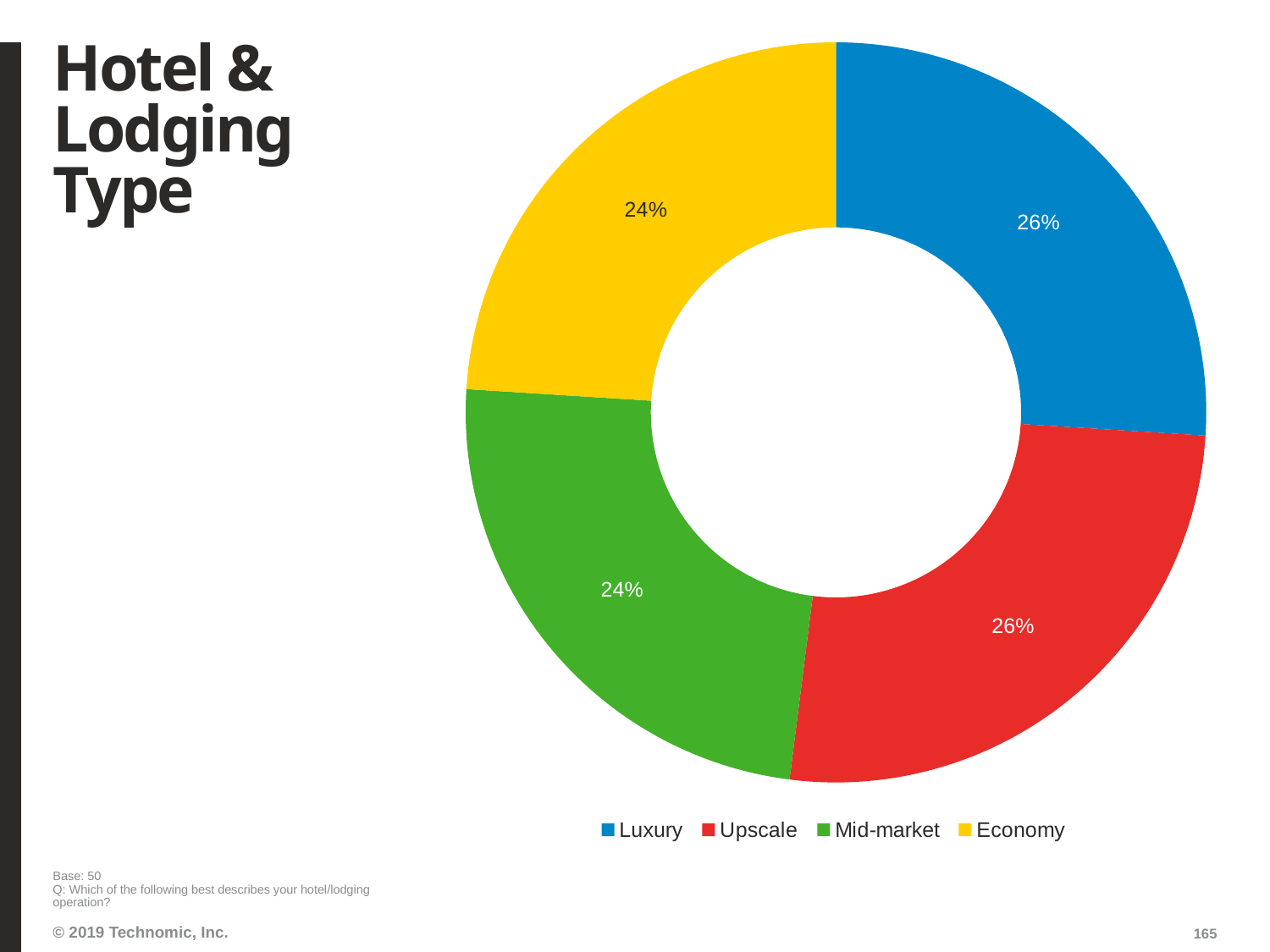
How many categories are shown in the chart? 4 Which is larger, the Luxury slice or the Mid-market slice? Luxury What kind of chart is shown on the slide? Pie chart (doughnut) What percentage of the pie chart is Economy? 24% Which is larger, the Economy slice or the Upscale slice? Upscale What share of the pie does the Economy slice represent? 24% What percentage of the pie chart is Luxury? 26% What percentage of the pie chart is Mid-market? 24% What is the difference in percentage points between the Upscale and Economy slices? 2 percentage points What colour represents Mid-market in the chart? Green How many entries does the legend list? 4 What percentage of the pie chart is Upscale? 26%